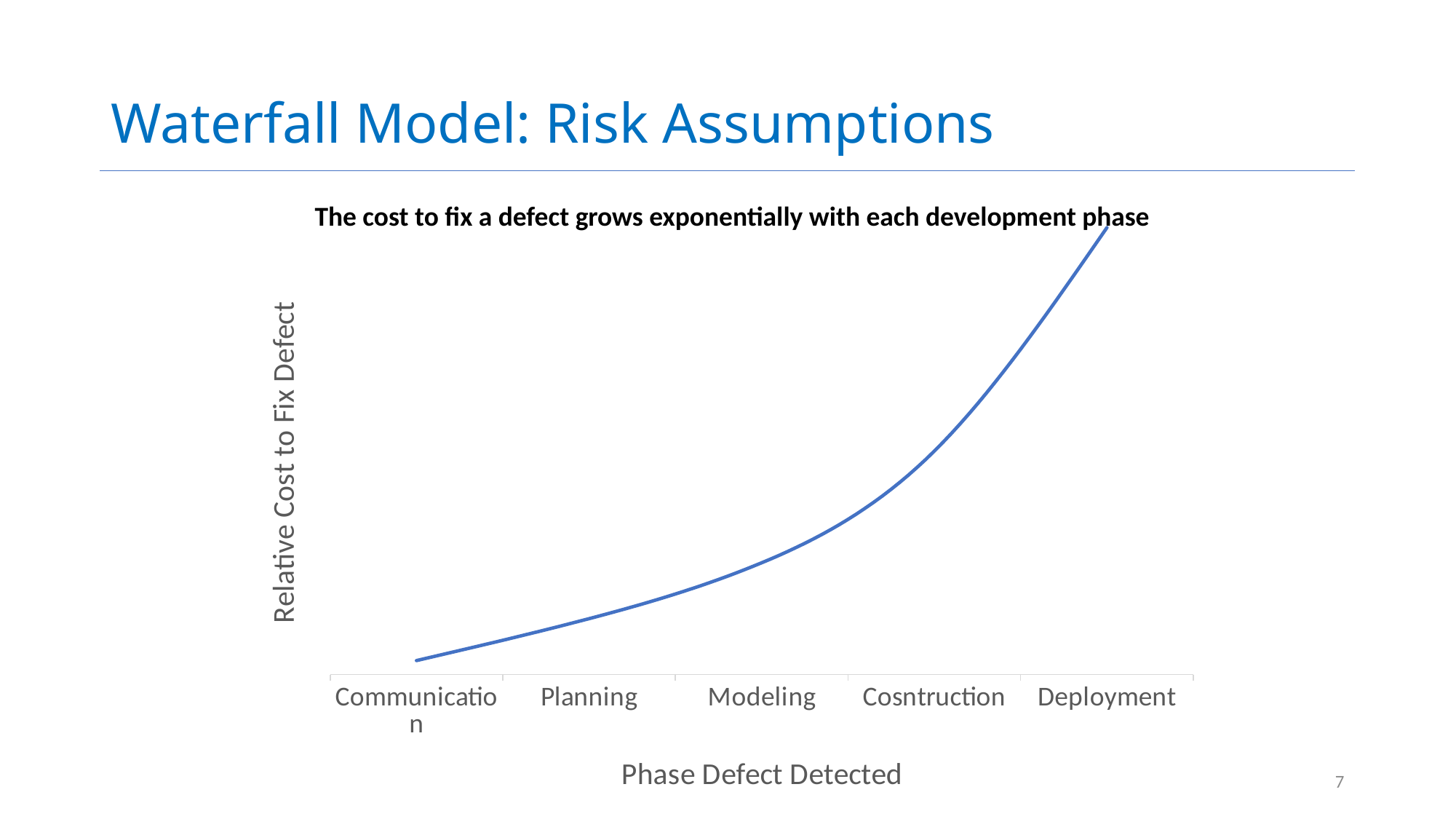
How many phases are shown along the x axis of the chart? 5 Does the relative cost to fix a defect rise or fall from Communication to Deployment? Rise What is the label of the x axis of the chart? Phase Defect Detected Which phase has a higher relative cost to fix a defect, Planning or Cosntruction? Cosntruction Which phase has the highest relative cost to fix a defect? Deployment Which phase has a lower relative cost to fix a defect, Modeling or Deployment? Modeling What kind of chart is shown on the slide? Line chart Which phase has a higher relative cost to fix a defect, Communication or Modeling? Modeling What is the title of the chart? The cost to fix a defect grows exponentially with each development phase Which phase comes immediately after Modeling on the x axis? Cosntruction Which phase has the lowest relative cost to fix a defect? Communication